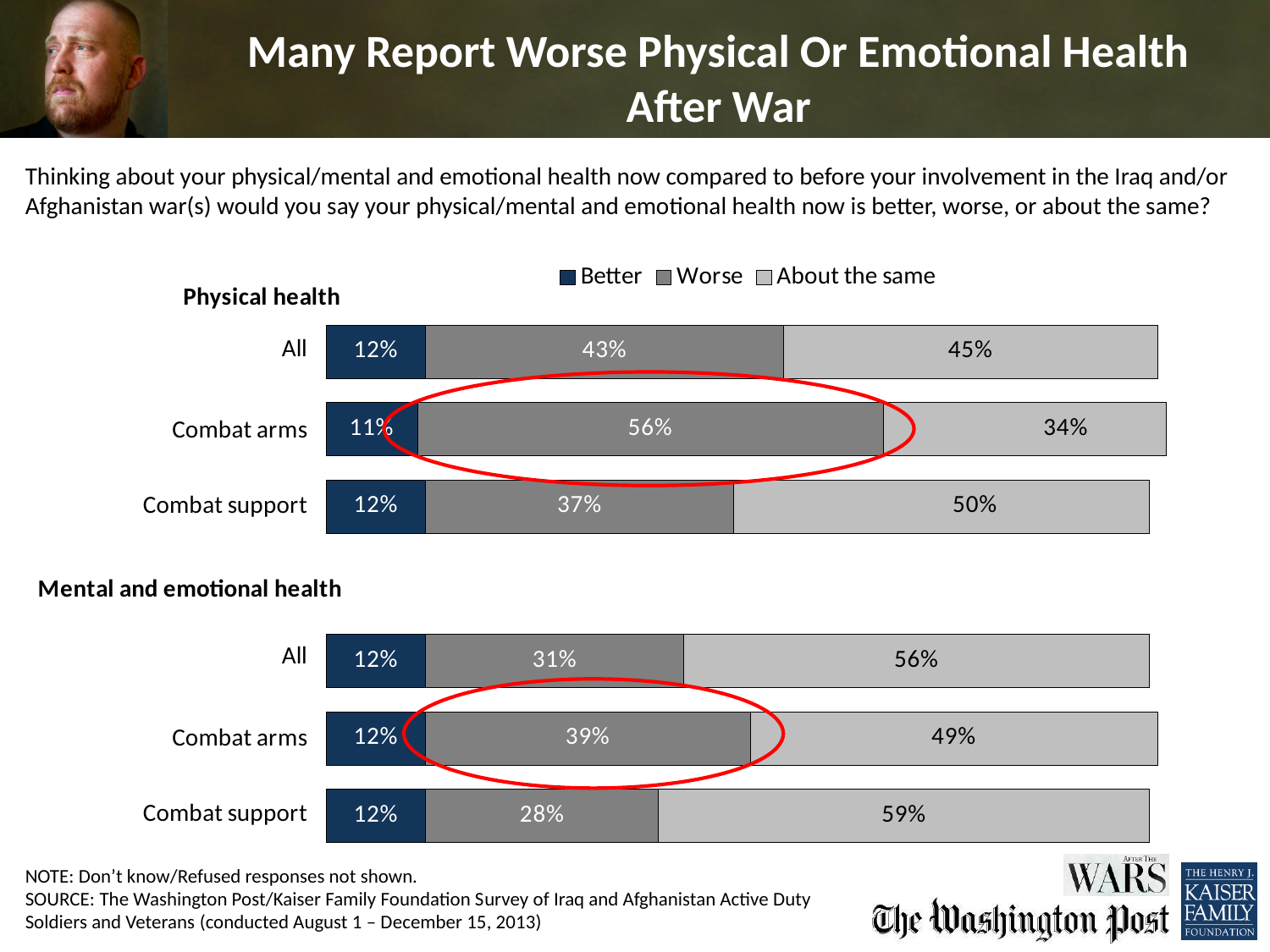
How many groups are shown in the Physical health chart? 3 In the Physical health chart, what percentage of Combat arms respondents report worse physical health? 56% In the Physical health chart, what percentage of All respondents report better physical health? 12% What type of chart is used for the Mental and emotional health data? Stacked bar chart In the Mental and emotional health chart, is the Worse share larger for Combat arms or for All? Combat arms Which legend entry is shown in dark blue? Better In the Physical health chart, what is the difference between the Worse percentages for Combat arms and Combat support? 19 percentage points How many series does the legend list? 3 In the Mental and emotional health chart, which group has the lowest share reporting worse mental and emotional health? Combat support In the Mental and emotional health chart, what percentage of Combat support respondents say their health is about the same? 59% In the Physical health chart, which group has the highest share reporting worse physical health? Combat arms In the Mental and emotional health chart, what is the total of the three segments for the Combat arms bar? 100%